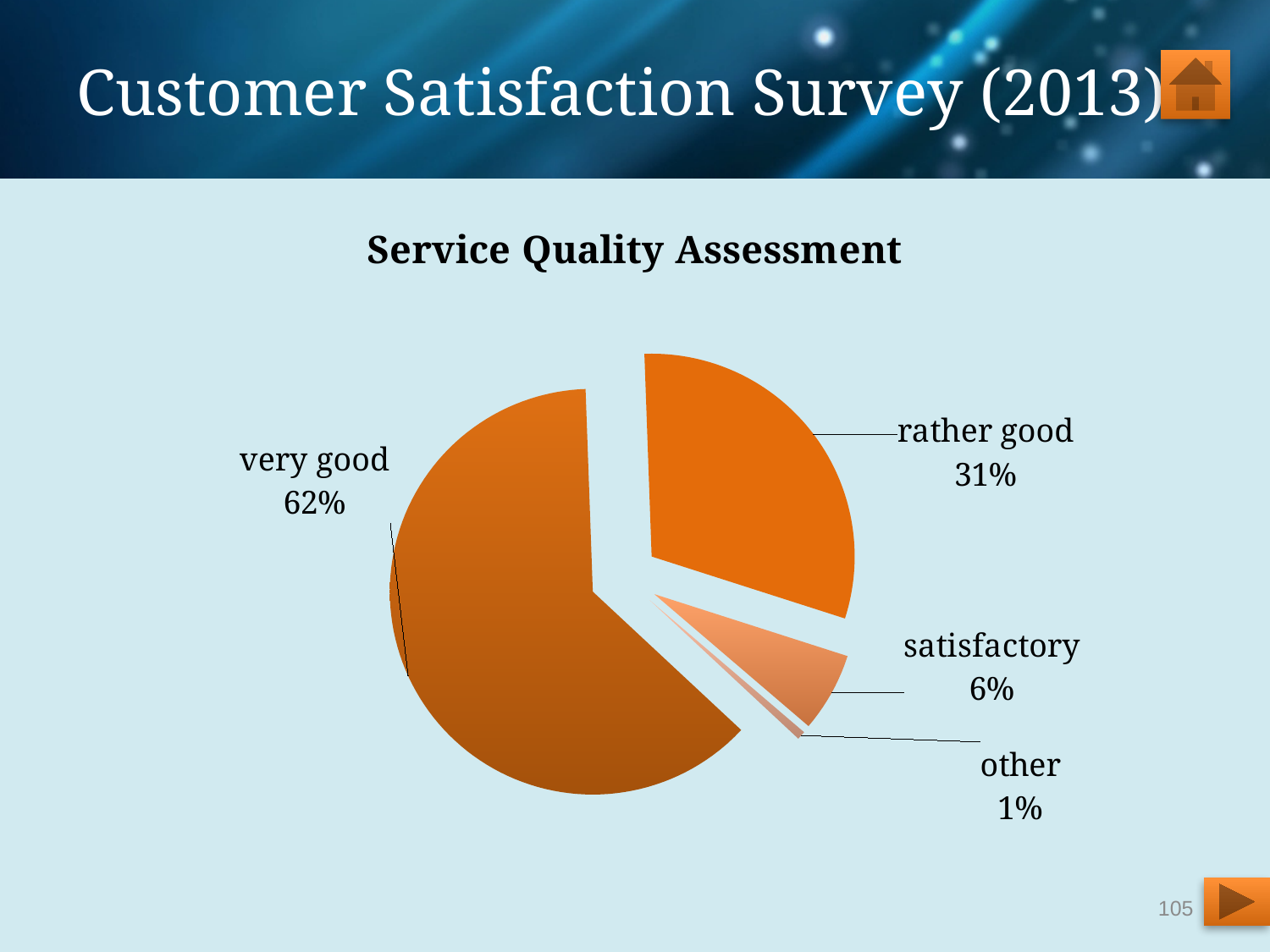
Which category has the largest slice of the pie? very good What is the difference in percentage points between "very good" and "rather good"? 31 Which category has the smallest slice of the pie? other Which is larger, the share for "satisfactory" or the share for "other"? satisfactory What is the combined share of "very good" and "rather good"? 93% What share of the pie is labelled "other"? 1% What type of chart is shown on the slide? pie chart What share of the pie is labelled "satisfactory"? 6% What share of the pie is labelled "very good"? 62% What share of the pie is labelled "rather good"? 31% How many slices does the pie chart have? 4 What is the title of the chart? Service Quality Assessment